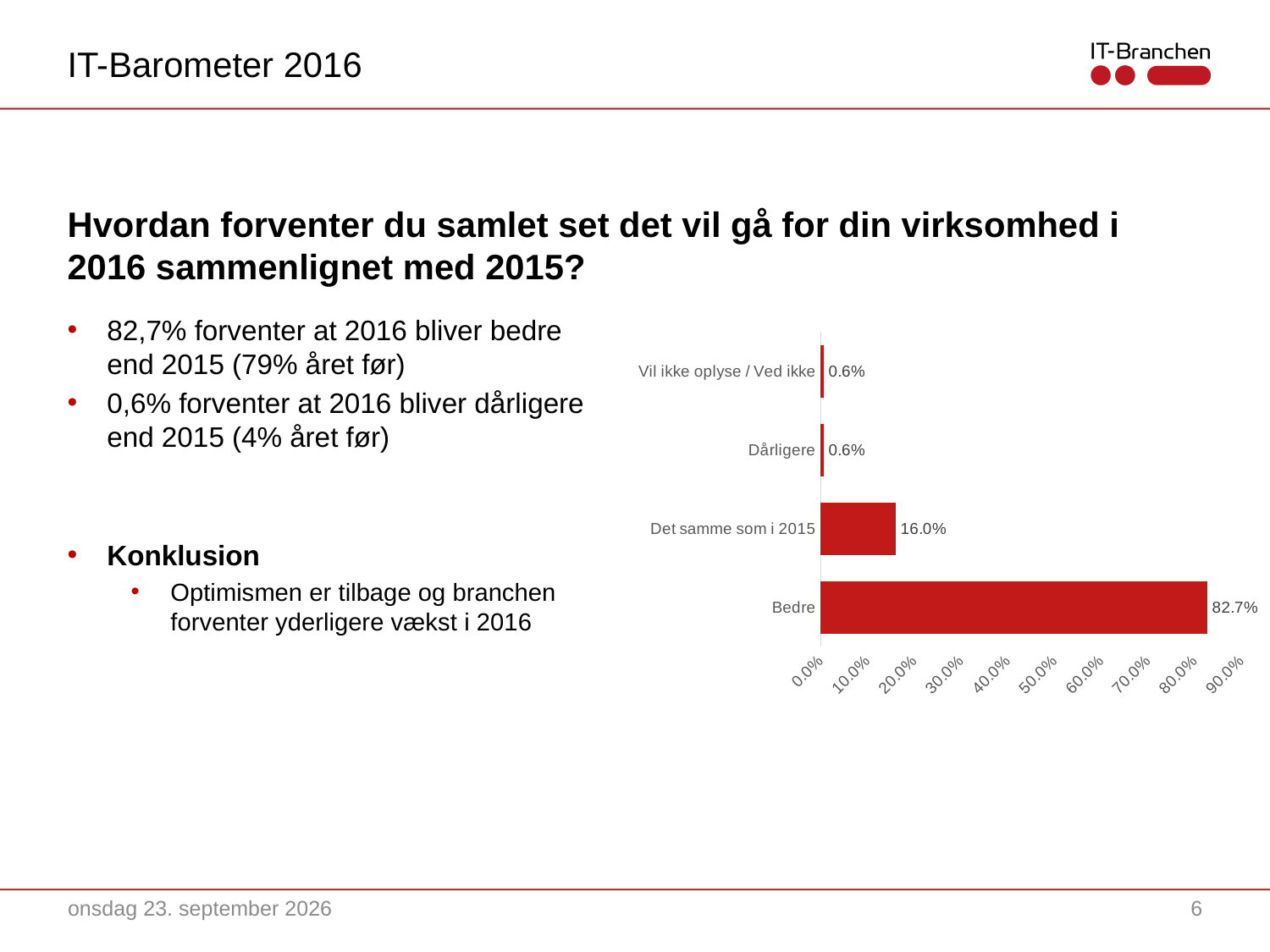
What kind of chart is shown on the slide? Bar chart What is the difference between the values for "Det samme som i 2015" and "Dårligere"? 15.4% What is the value for "Bedre"? 82.7% How many categories are shown in the chart? 4 Which category has the highest value? Bedre Is the value for "Det samme som i 2015" greater or less than 20.0%? less What is the difference between the values for "Bedre" and "Det samme som i 2015"? 66.7% What is the value for "Dårligere"? 0.6% Which is larger, the value for "Bedre" or the value for "Det samme som i 2015"? Bedre Is the value for "Bedre" greater or less than 80.0%? greater What is the value for "Det samme som i 2015"? 16.0% What is the value for "Vil ikke oplyse / Ved ikke"? 0.6%